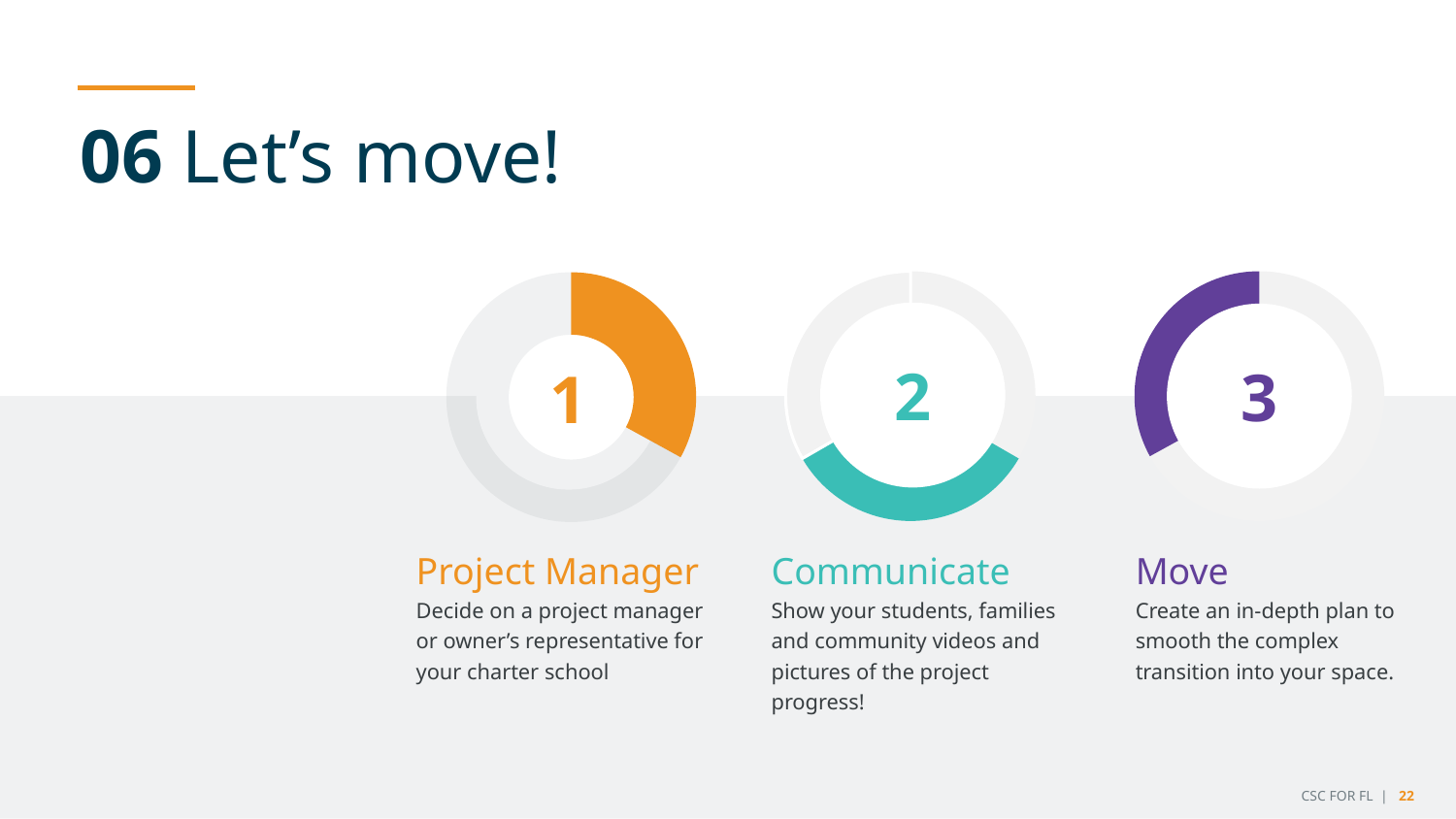
What number is printed in the centre of the teal doughnut chart? 2 How many doughnut charts are shown on the slide? 3 What number is printed in the centre of the purple doughnut chart? 3 Which heading appears below the teal doughnut chart? Communicate What colour is the filled segment of the doughnut chart above the heading 'Move'? purple What kind of chart is used for each of the three numbered steps on the slide? doughnut chart What number is printed in the centre of the orange doughnut chart? 1